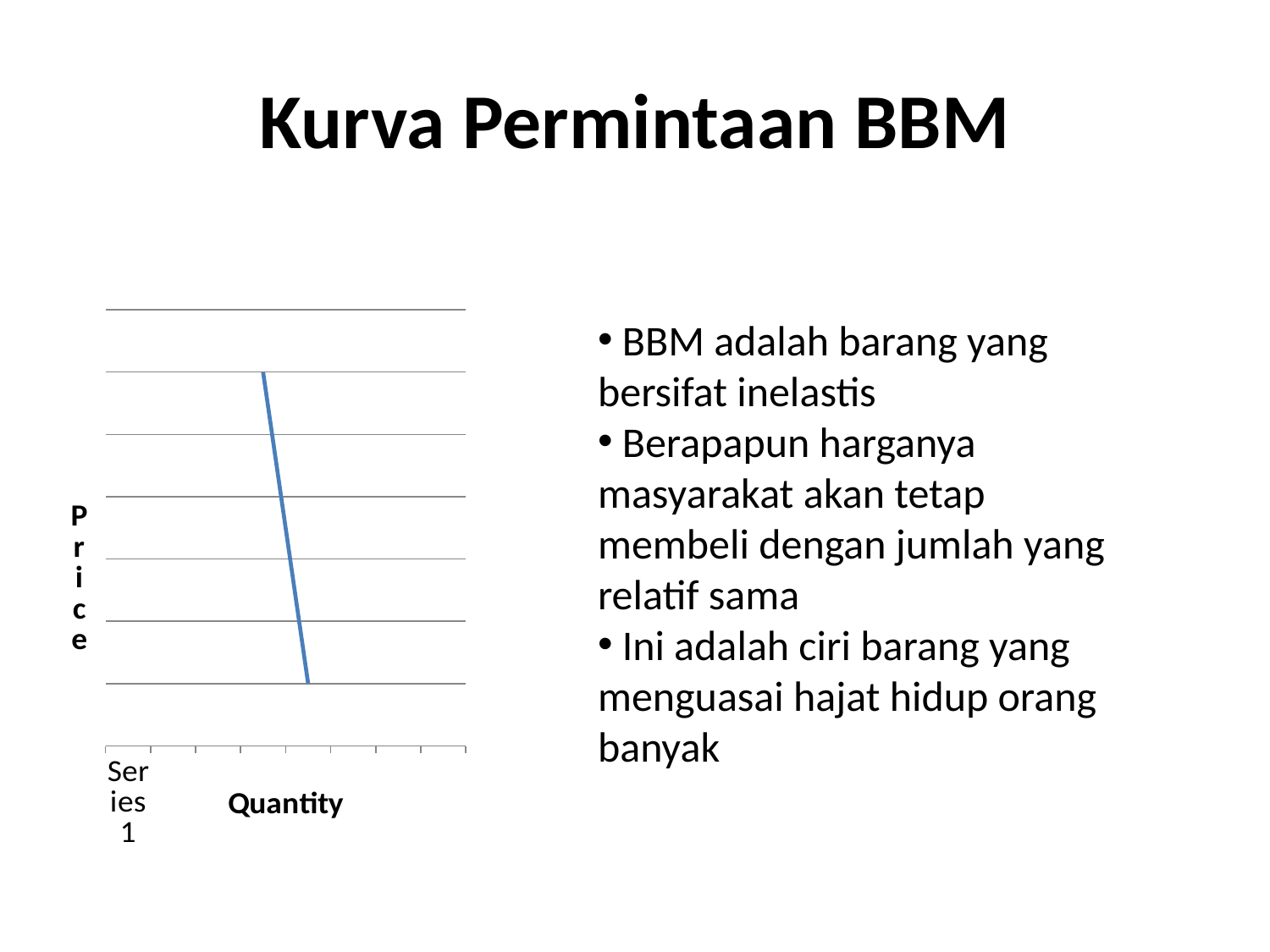
What is the title of the horizontal (x) axis of the chart? Quantity How many lines are plotted on the chart? 1 What is the title of the vertical (y) axis of the chart? Price What kind of chart is shown on the slide? line chart Does the plotted line rise or fall as you move from left to right along the x axis? fall